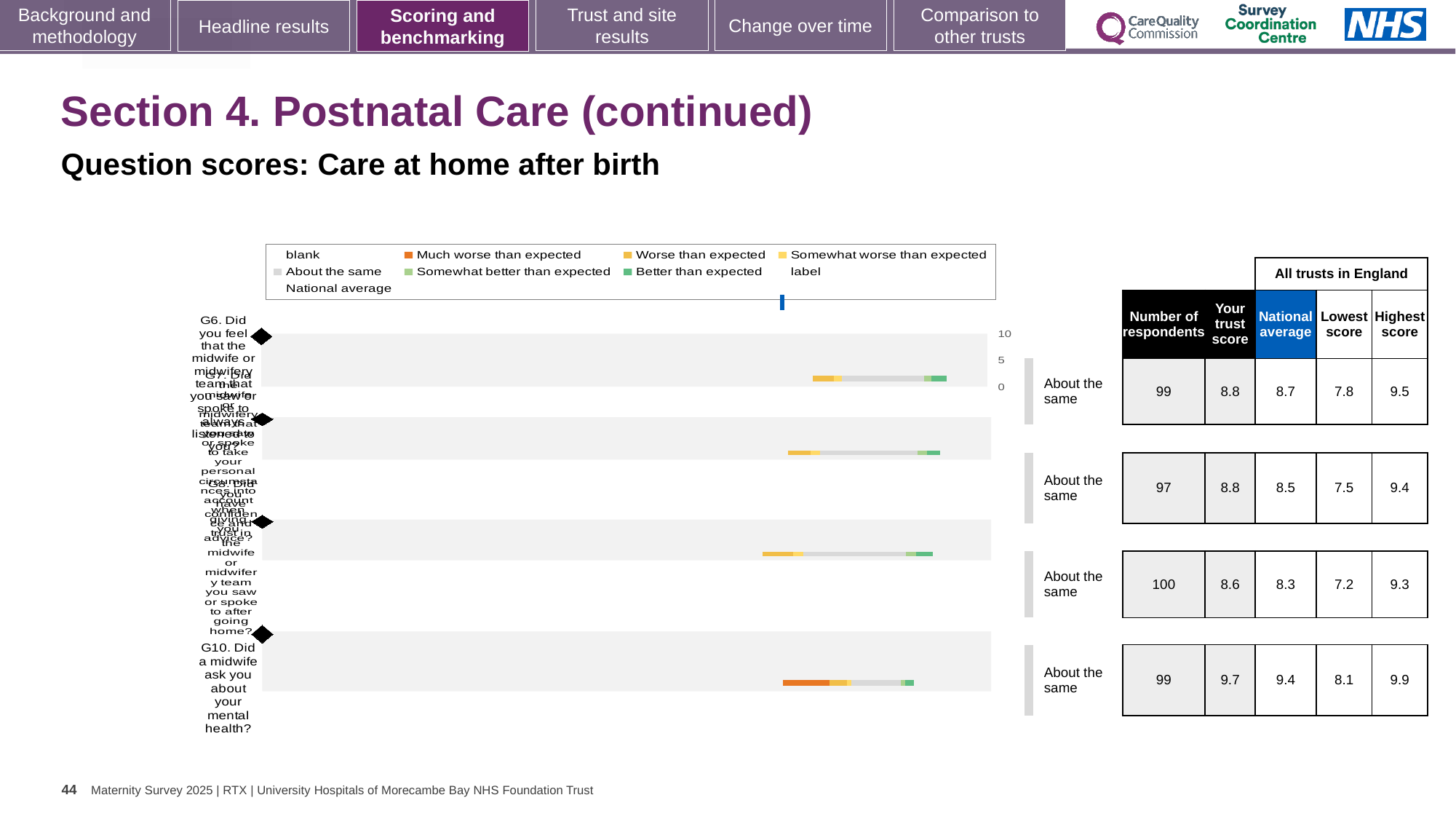
What rating is shown next to the bar for G10 (mental health)? About the same How many bars (questions) are plotted in the chart? 4 What is the highest value shown on the chart's axis? 10 How many entries does the chart legend list? 9 Which legend entry is shown in orange? Much worse than expected What is the label of the bottom bar in the chart? G10. Did a midwife ask you about your mental health? What is the subtitle describing the chart's topic? Question scores: Care at home after birth What kind of chart is shown on the slide? bar chart